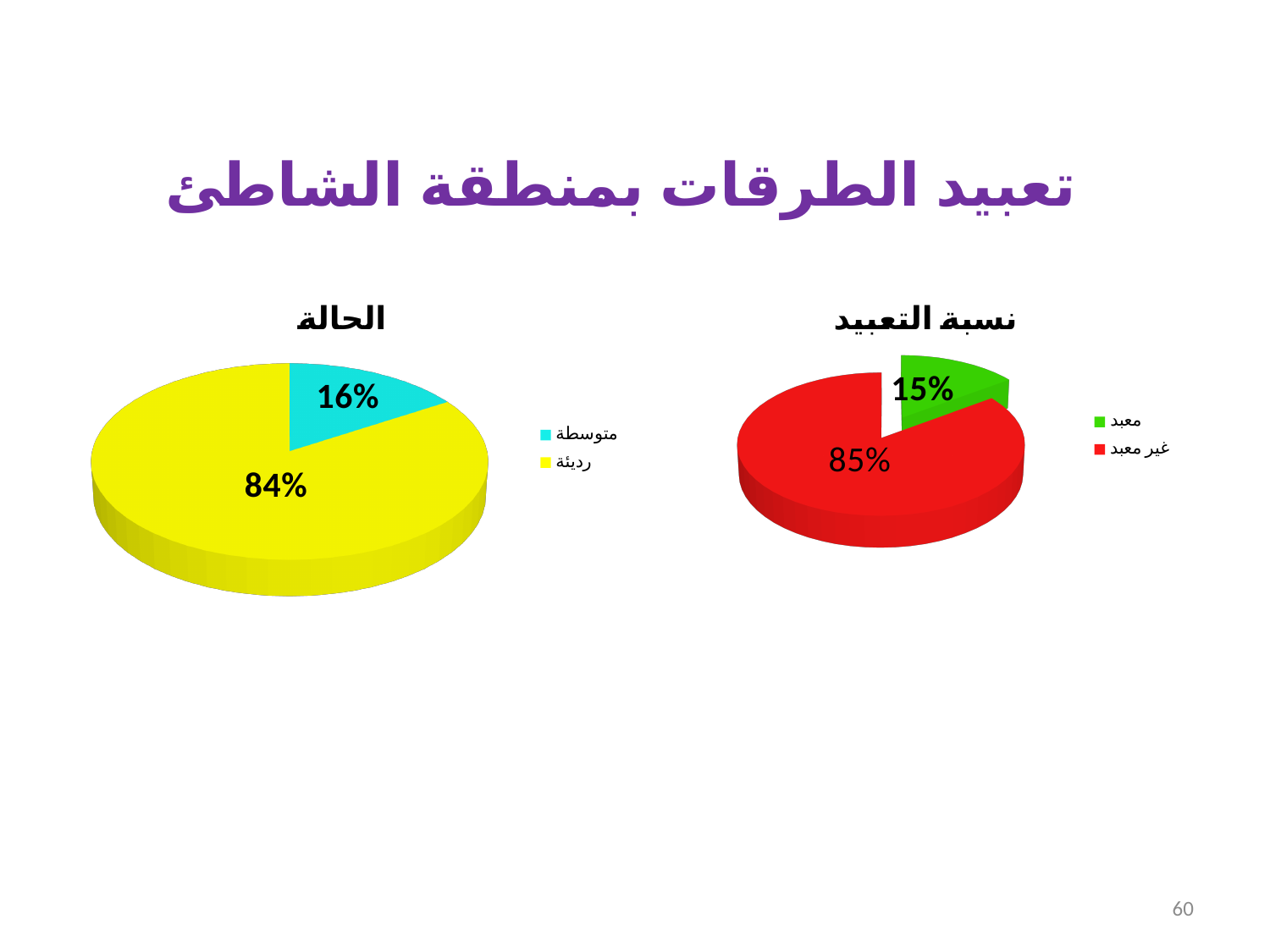
In the chart titled "الحالة" (left), what is the difference between the "رديئة" and "متوسطة" shares? 68% In the chart titled "نسبة التعبيد" (right), which category has the smallest slice? معبد In the chart titled "الحالة" (left), which is larger: "متوسطة" or "رديئة"? رديئة In the chart titled "نسبة التعبيد" (right), what share of the pie is labelled "غير معبد"? 85% In the chart titled "نسبة التعبيد" (right), what colour is the "غير معبد" slice? Red In the chart titled "نسبة التعبيد" (right), what share of the pie is labelled "معبد"? 15% What type of chart is the chart titled "نسبة التعبيد" (right)? Pie chart How many categories does the legend of the chart titled "الحالة" (left) list? 2 In the chart titled "الحالة" (left), what share of the pie is labelled "رديئة"? 84% In the chart titled "الحالة" (left), which category has the largest slice? رديئة In the chart titled "نسبة التعبيد" (right), what is the difference between the "غير معبد" and "معبد" shares? 70%